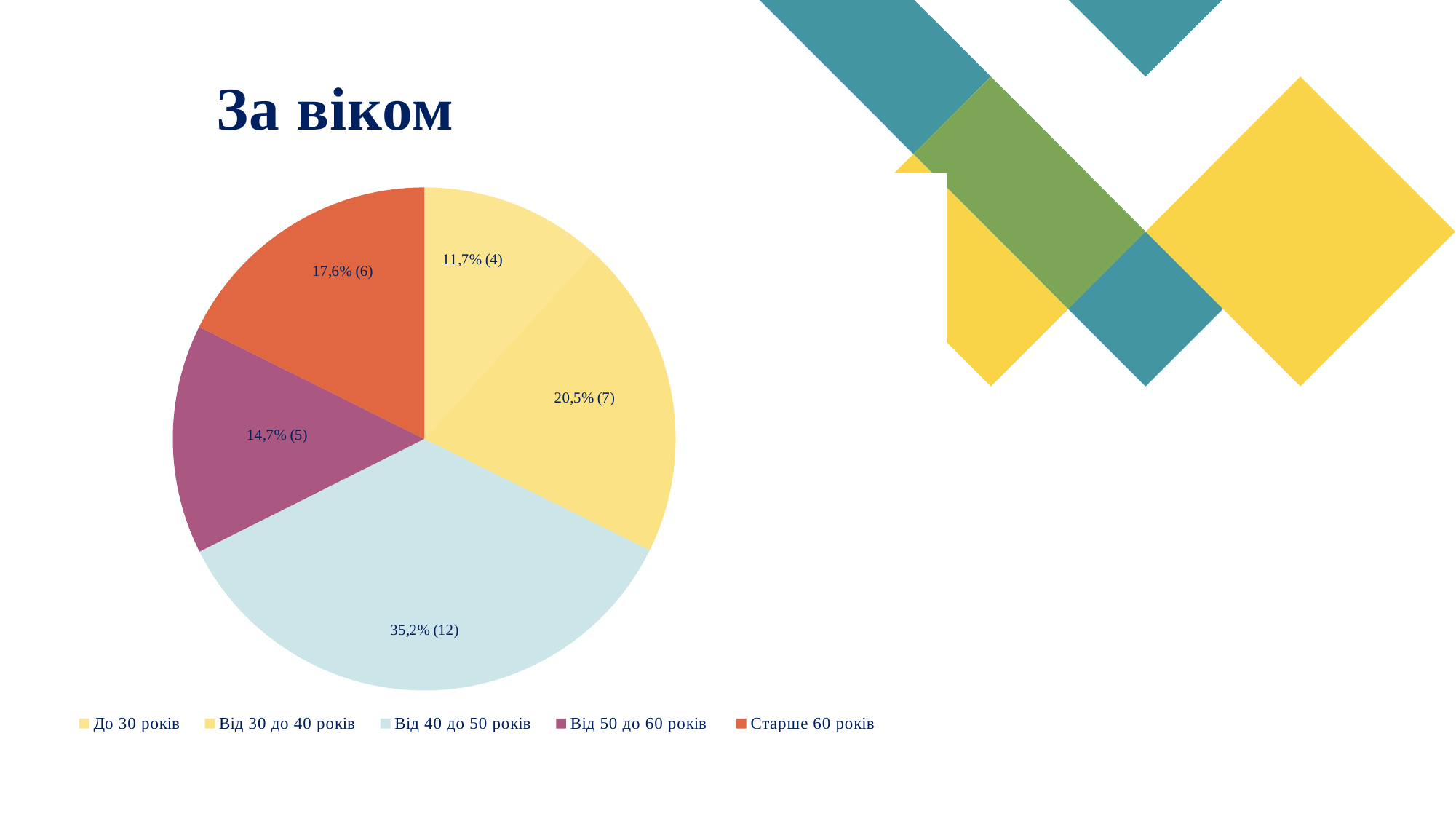
What is the title of the chart? За віком What colour is the slice for 'Від 50 до 60 років'? Purple What is the data label for the slice 'Від 40 до 50 років'? 35,2% (12) Which age group has the smallest share of the pie? До 30 років What is the difference in count between 'Від 40 до 50 років' (12) and 'Від 50 до 60 років' (5)? 7 How many slices does the pie chart have? 5 Which is larger: the share for 'Від 50 до 60 років' or 'Старше 60 років'? Старше 60 років Which age group has the largest share of the pie? Від 40 до 50 років What kind of chart is shown on the slide? Pie chart What percentage is shown for 'До 30 років'? 11,7% What is the data label for 'Старше 60 років'? 17,6% (6) How many people are in the 'Від 30 до 40 років' group according to the label? 7